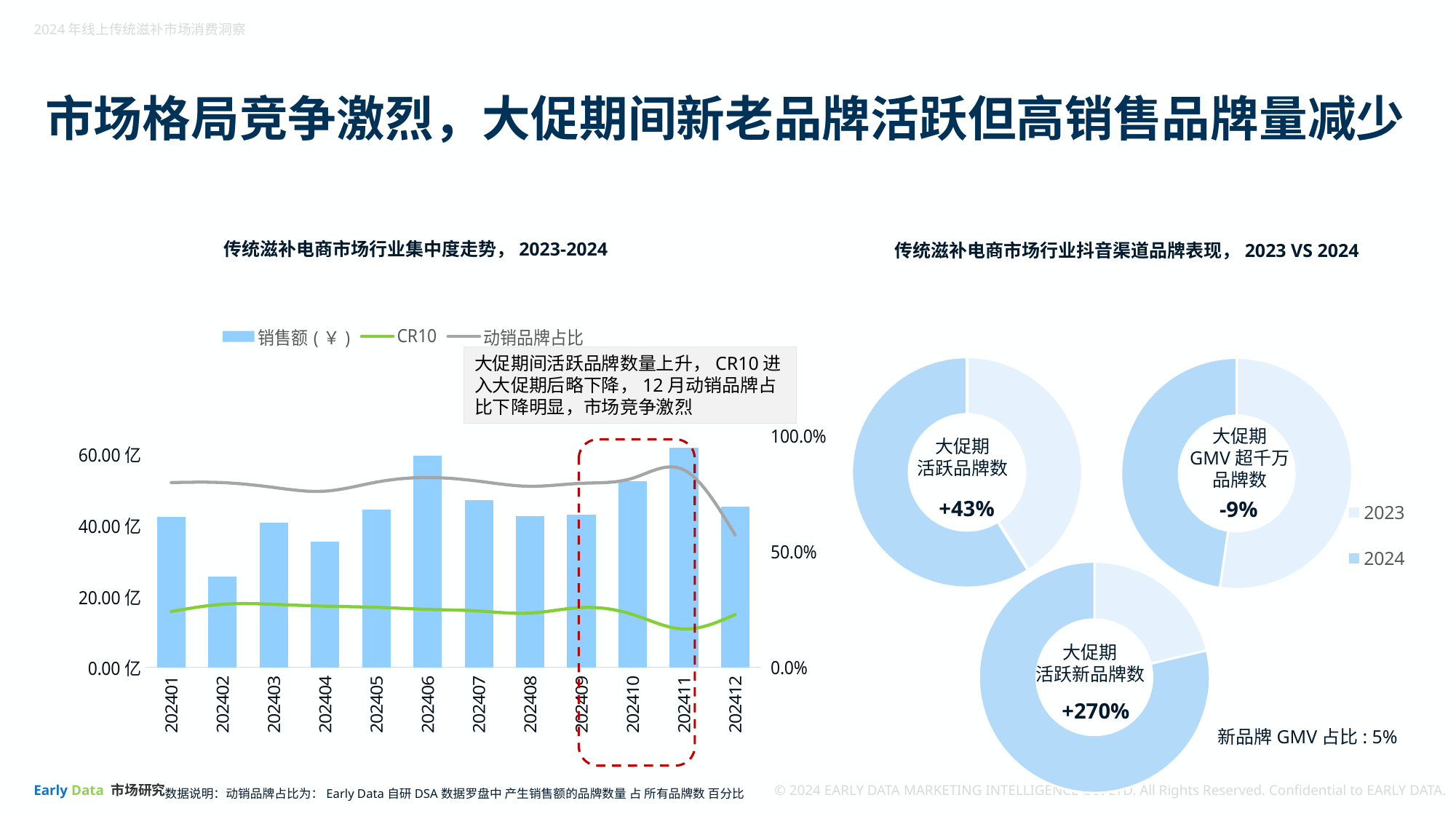
In the left chart titled 传统滋补电商市场行业集中度走势，2023-2024, how many months are shown on the x axis? 12 On the right side of the slide, which two years does the legend of the donut charts list? 2023 and 2024 In the left chart titled 传统滋补电商市场行业集中度走势，2023-2024, what kind of chart is used to show 销售额（¥）? bar chart On the right side of the slide, what percentage is shown in the centre of the 大促期活跃新品牌数 donut chart? +270% In the left chart titled 传统滋补电商市场行业集中度走势，2023-2024, how many series does the legend list? 3 In the left chart titled 传统滋补电商市场行业集中度走势，2023-2024, does the 动销品牌占比 line rise or fall from 202411 to 202412? fall In the left chart titled 传统滋补电商市场行业集中度走势，2023-2024, is the 销售额（¥） bar for 202406 greater or less than 40.00 亿? greater In the left chart titled 传统滋补电商市场行业集中度走势，2023-2024, which month has the lowest 销售额（¥） bar? 202402 In the left chart titled 传统滋补电商市场行业集中度走势，2023-2024, is the 销售额（¥） bar for 202402 greater or less than 40.00 亿? less In the left chart titled 传统滋补电商市场行业集中度走势，2023-2024, which has the larger 销售额（¥） bar, 202410 or 202402? 202410 In the left chart titled 传统滋补电商市场行业集中度走势，2023-2024, which series is drawn as a green line? CR10 On the right side of the slide, what percentage is shown in the centre of the 大促期 GMV 超千万品牌数 donut chart? -9%